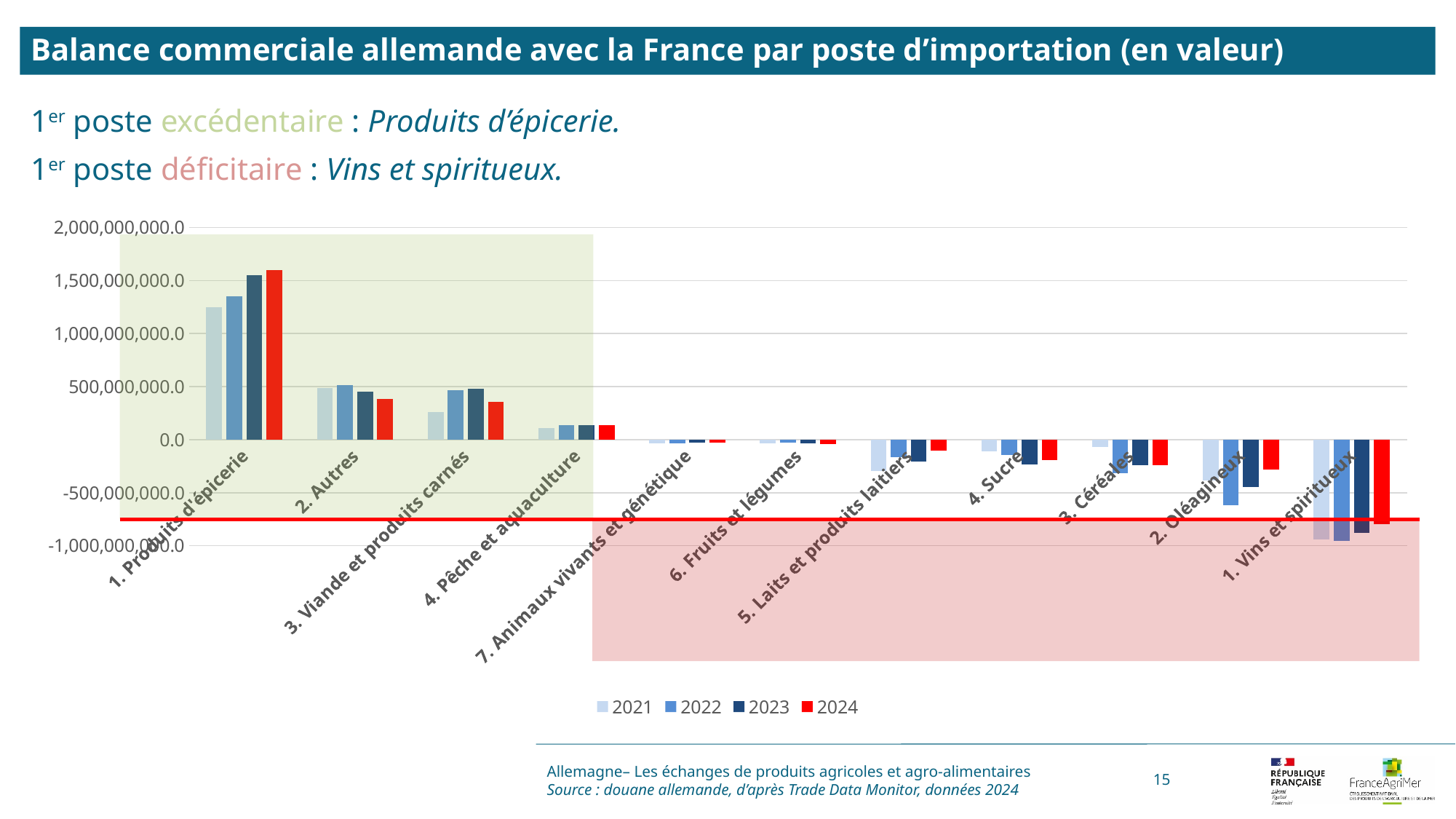
How many import categories are shown on the x axis? 11 Which category has the lowest (most negative) 2024 value? 1. Vins et spiritueux Is the 2024 value for 2. Oléagineux greater or less than -500,000,000.0? greater For 1. Produits d'épicerie, which is larger: the 2021 value or the 2024 value? 2024 Is the 2024 value for 1. Produits d'épicerie greater or less than 1,000,000,000.0? greater Which category has the highest 2024 value? 1. Produits d'épicerie How many series does the legend list? 4 For 2. Autres, which is larger: the 2022 value or the 2024 value? 2022 What colour represents the 2024 series in the legend? red What kind of chart is shown on the slide? bar chart Is the 2022 value for 1. Vins et spiritueux greater or less than -500,000,000.0? less Do the values for 1. Produits d'épicerie rise or fall from 2021 to 2024? rise